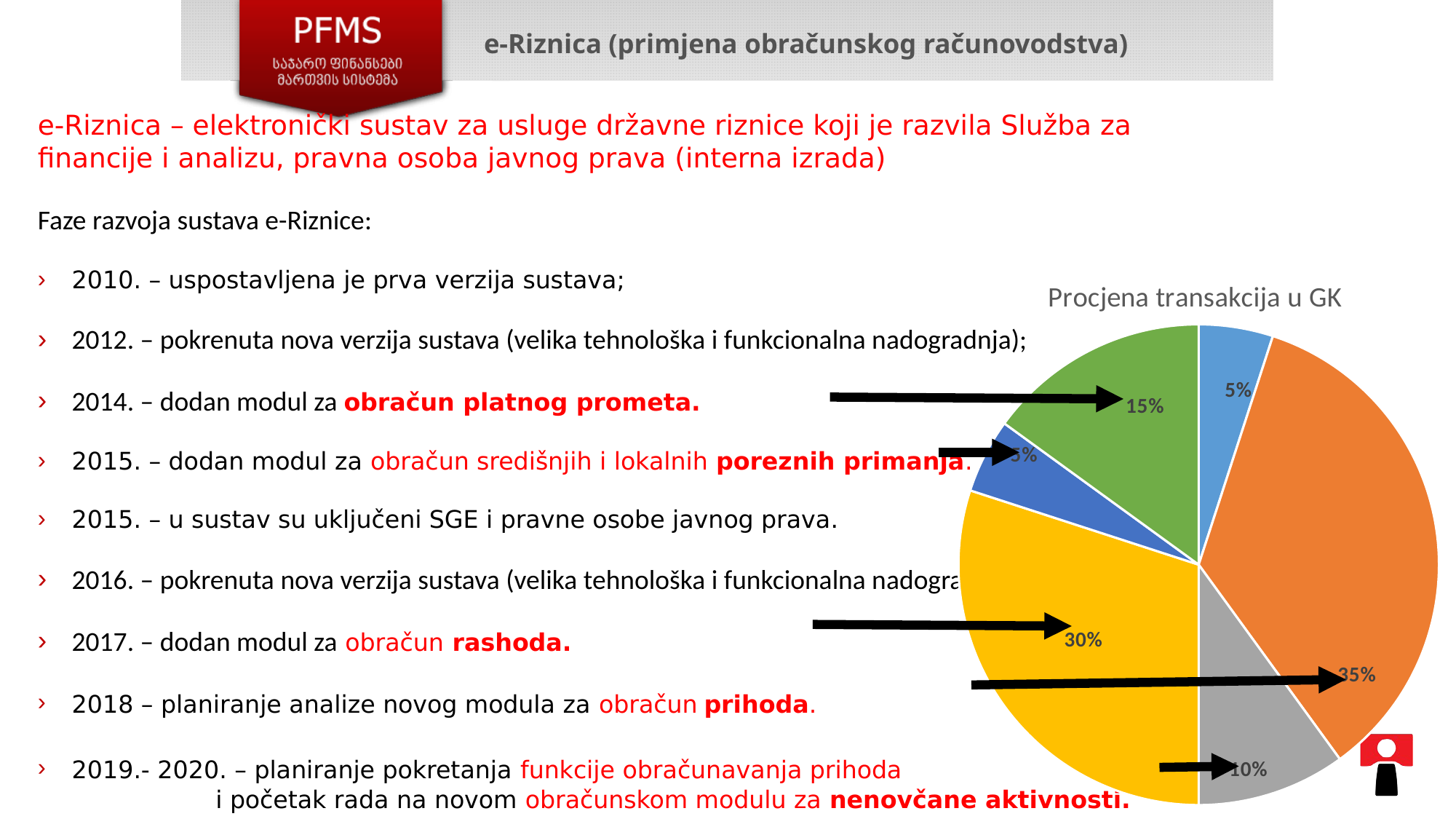
What percentage is shown on the green slice of the pie chart? 15% What is the difference between the green slice and the gray slice in the pie chart? 5% What kind of chart is shown on the slide? pie chart What percentage is shown on the orange slice of the pie chart? 35% How many slices does the pie chart have? 6 Which is larger in the pie chart, the green slice or the gray slice? green What is the difference between the orange slice and the yellow slice in the pie chart? 5% Which colour slice is the largest in the pie chart? orange What is the title of the pie chart? Procjena transakcija u GK What percentage is shown on the gray slice of the pie chart? 10% What percentage is shown on the yellow slice of the pie chart? 30% What percentage is shown on the light blue slice at the top of the pie chart? 5%